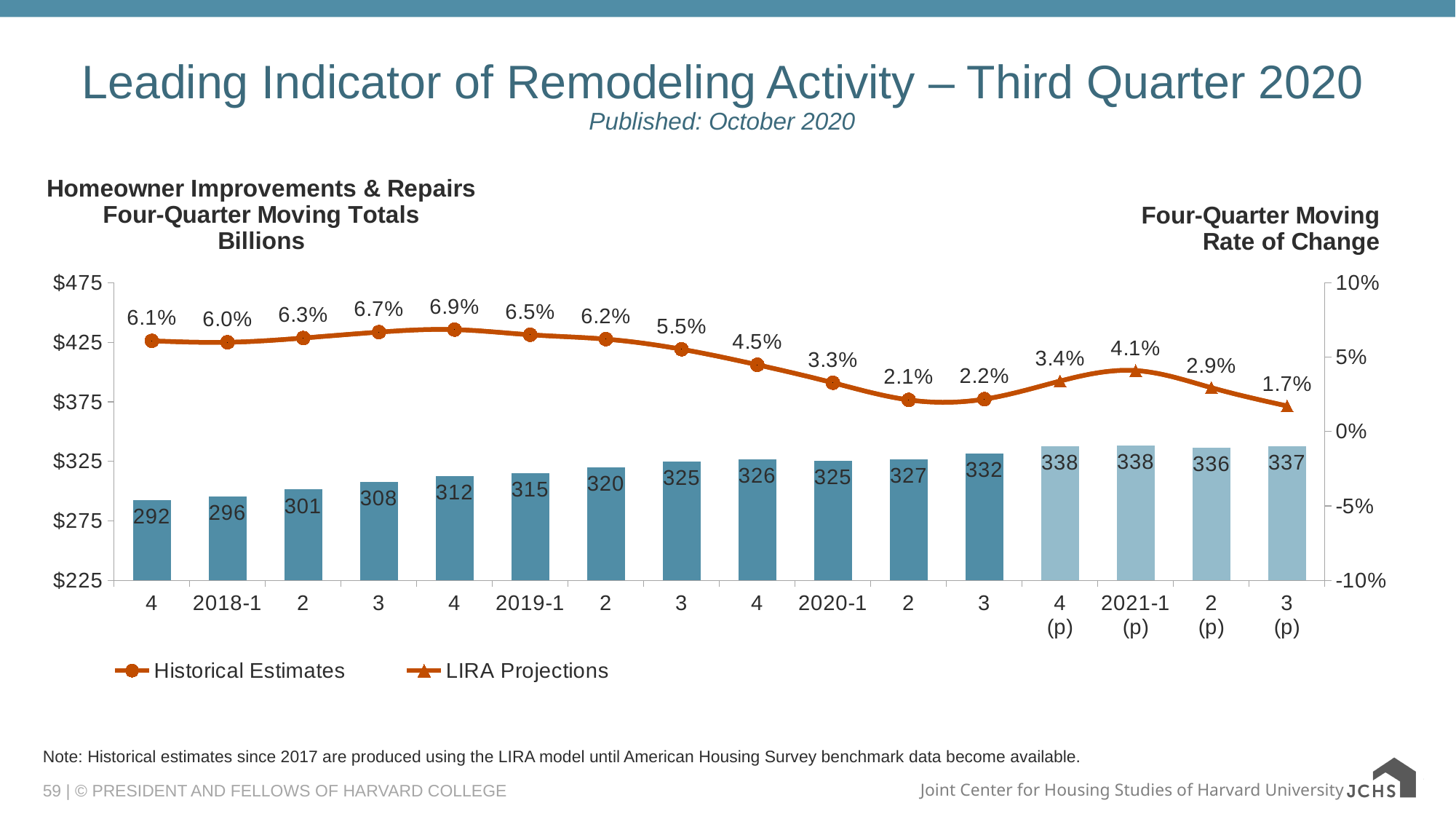
How many quarters are shown on the x axis? 16 What is the projected four-quarter moving rate of change for 2021-1 (p)? 4.1% Which quarter has the lowest four-quarter moving rate of change? 2021-3 (p) How many series does the legend list? 2 What is the difference in the four-quarter moving total between 2020-3 and 2018-1? 36 Which is larger, the four-quarter moving total for 2019-2 or for 2020-2? 2020-2 What is the difference in the rate of change between 2018-4 and 2020-2? 4.8 percentage points What kind of chart is this? Combined bar and line chart What is the four-quarter moving rate of change for 2019-1? 6.5% What is the four-quarter moving total (in billions) for 2020-1? 325 Which quarter has the lowest four-quarter moving total in billions? 2017-4 Which quarter has the highest four-quarter moving rate of change? 2018-4